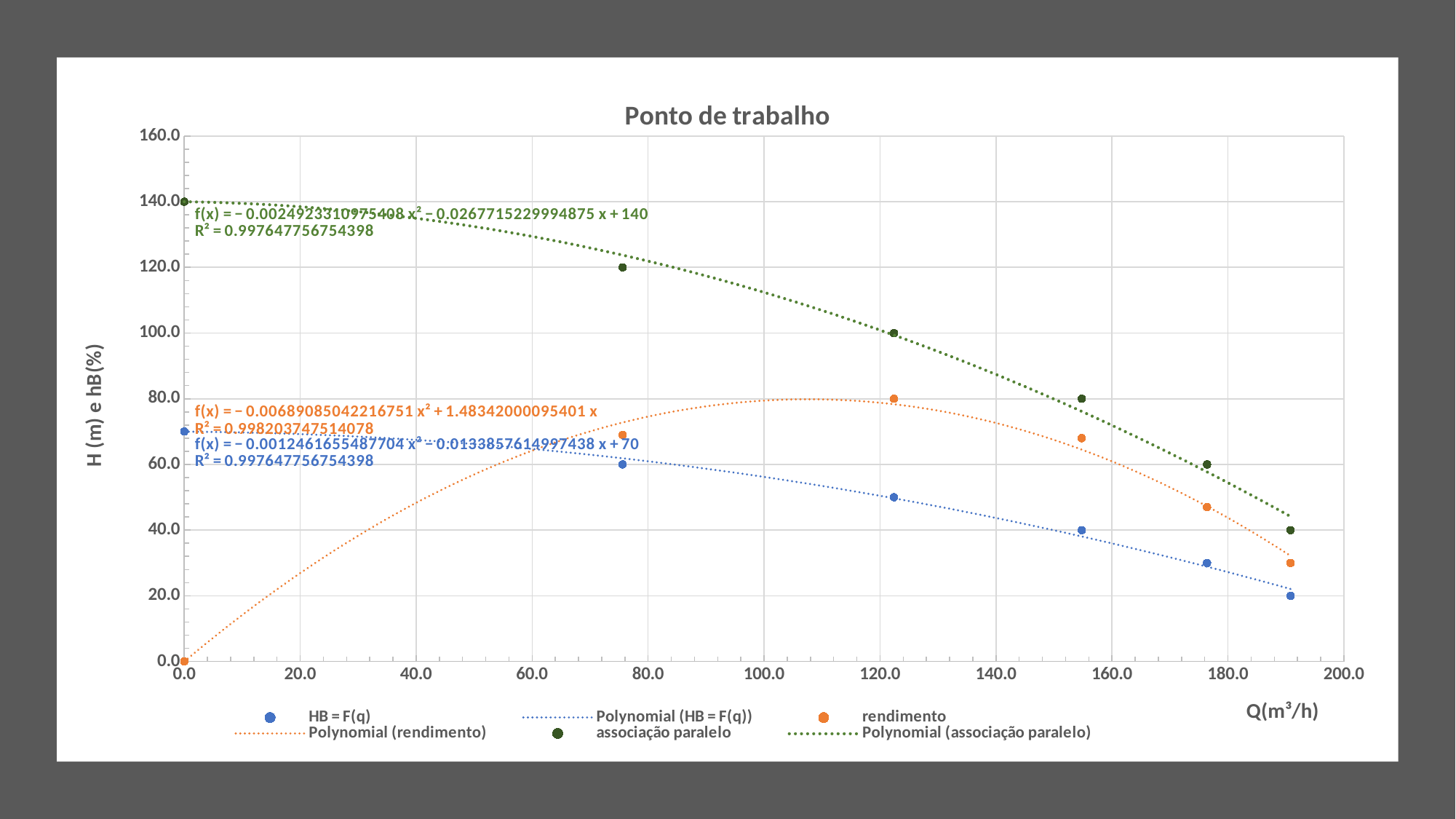
What is the title of the chart? Ponto de trabalho How many entries does the chart legend list? 6 Is the value of the 'associação paralelo' series at its second point (near Q = 76) greater or less than 100.0? greater What is the value of the 'rendimento' series at Q = 0.0? 0.0 At the rightmost plotted Q (near 190), which series has the larger value: 'associação paralelo' or 'HB = F(q)'? associação paralelo What is the value of the 'associação paralelo' series at Q = 0.0? 140.0 What R² value is shown for the green 'associação paralelo' trendline? 0.997647756754398 Is the value of the 'HB = F(q)' series at its rightmost point (near Q = 190) greater or less than 40.0? less What kind of chart is shown on the slide? scatter chart How many data points are plotted for the 'associação paralelo' series? 6 Do the values of the 'associação paralelo' series rise or fall as Q increases? fall Do the values of the 'HB = F(q)' series rise or fall as Q increases? fall